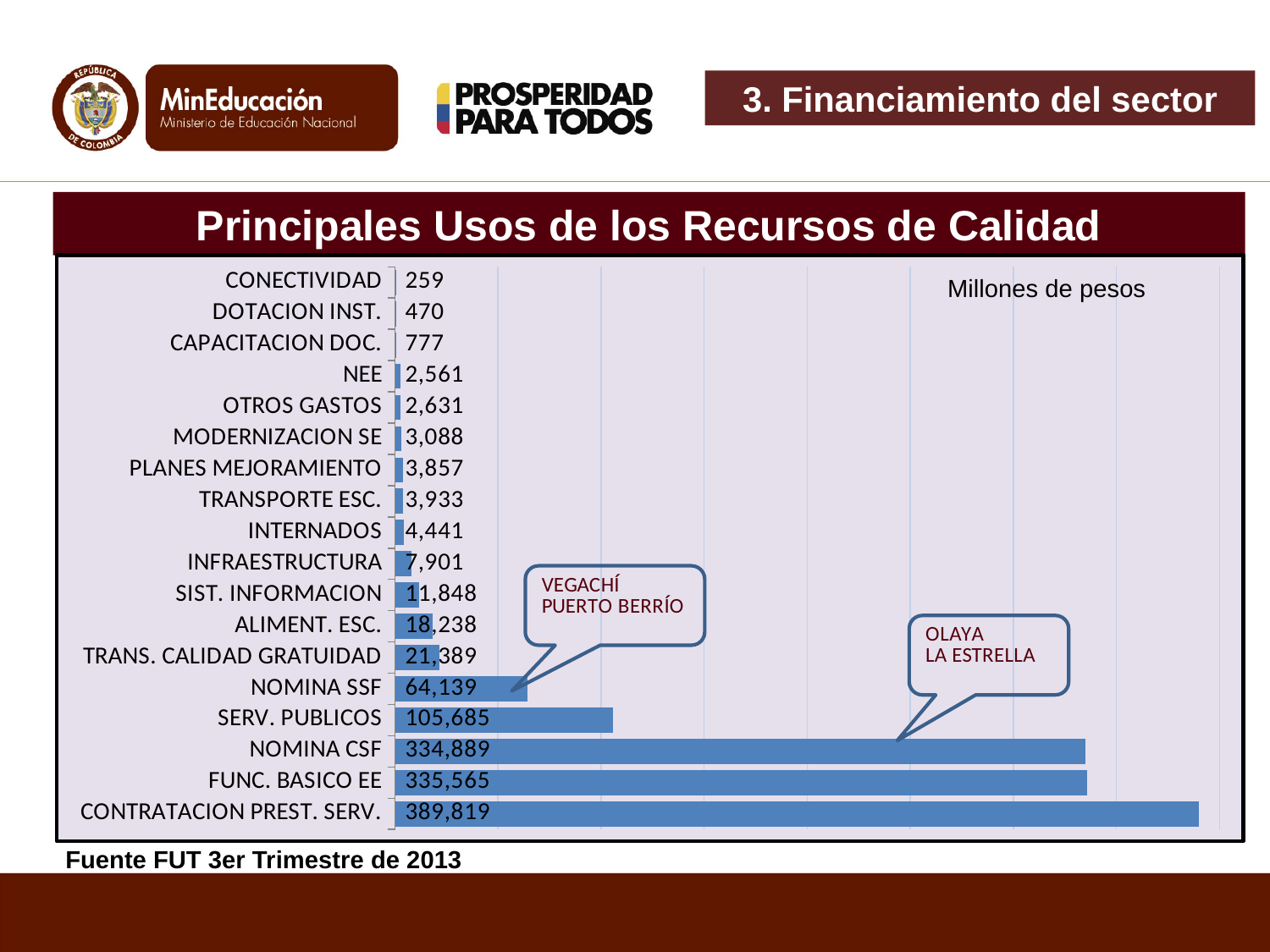
Which category has the highest value? CONTRATACION PREST. SERV. What kind of chart is shown on the slide? Bar chart How many categories are shown in the chart? 18 What is the value for INFRAESTRUCTURA? 7,901 What is the value for SERV. PUBLICOS? 105,685 What is the value for TRANS. CALIDAD GRATUIDAD? 21,389 Which category has the lowest value? CONECTIVIDAD Which is larger, the value for ALIMENT. ESC. or the value for SIST. INFORMACION? ALIMENT. ESC. What is the difference between the values for SERV. PUBLICOS and NOMINA SSF? 41,546 What is the title of the chart? Principales Usos de los Recursos de Calidad What is the value for NOMINA SSF? 64,139 What is the difference between the values for CONTRATACION PREST. SERV. and FUNC. BASICO EE? 54,254